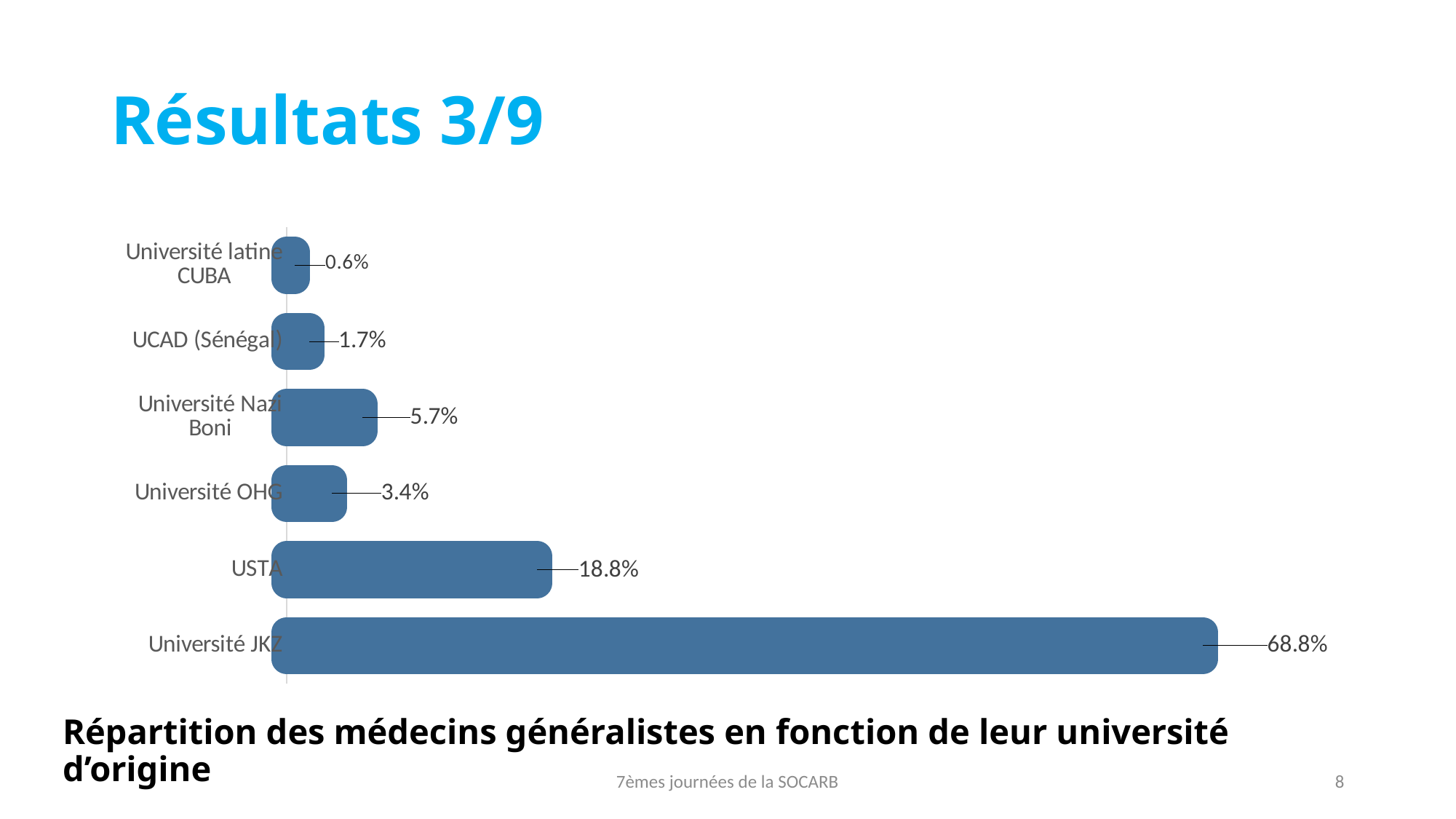
How many universities are shown in the chart? 6 What is the value for USTA? 18.8% What is the value for Université Nazi Boni? 5.7% What is the value for Université JKZ? 68.8% Which is larger, the value for Université OHG or the value for UCAD (Sénégal)? Université OHG Which university has the lowest value? Université latine CUBA What is the difference between the values for Université Nazi Boni and Université OHG? 2.3% What kind of chart is shown on the slide? Bar chart Which university has the highest value? Université JKZ What is the value for UCAD (Sénégal)? 1.7% What is the difference between the values for Université JKZ and USTA? 50.0% What is the caption below the chart? Répartition des médecins généralistes en fonction de leur université d'origine